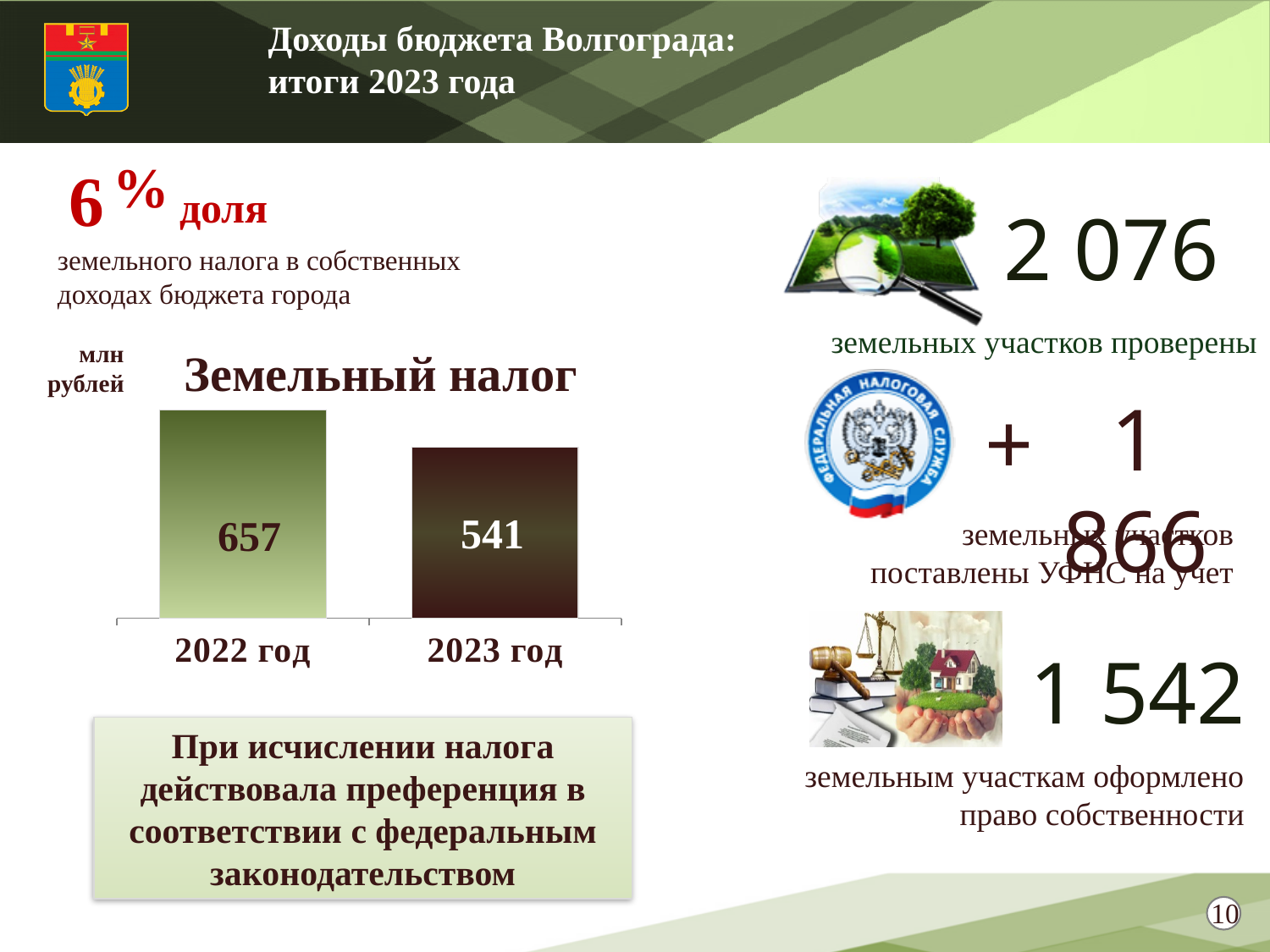
How many categories are shown in the Земельный налог chart? 2 What is the difference between the 2022 год and 2023 год values in the Земельный налог chart? 116 What unit is indicated for the values in the Земельный налог chart? млн рублей What is the title of the chart on the slide? Земельный налог What is the value for 2022 год in the Земельный налог chart? 657 Which year has the highest value in the Земельный налог chart? 2022 год Which year has the lowest value in the Земельный налог chart? 2023 год What is the value for 2023 год in the Земельный налог chart? 541 What kind of chart is the Земельный налог chart? bar chart Which is larger in the Земельный налог chart: the value for 2022 год or for 2023 год? 2022 год Do the values in the Земельный налог chart rise or fall from 2022 год to 2023 год? fall